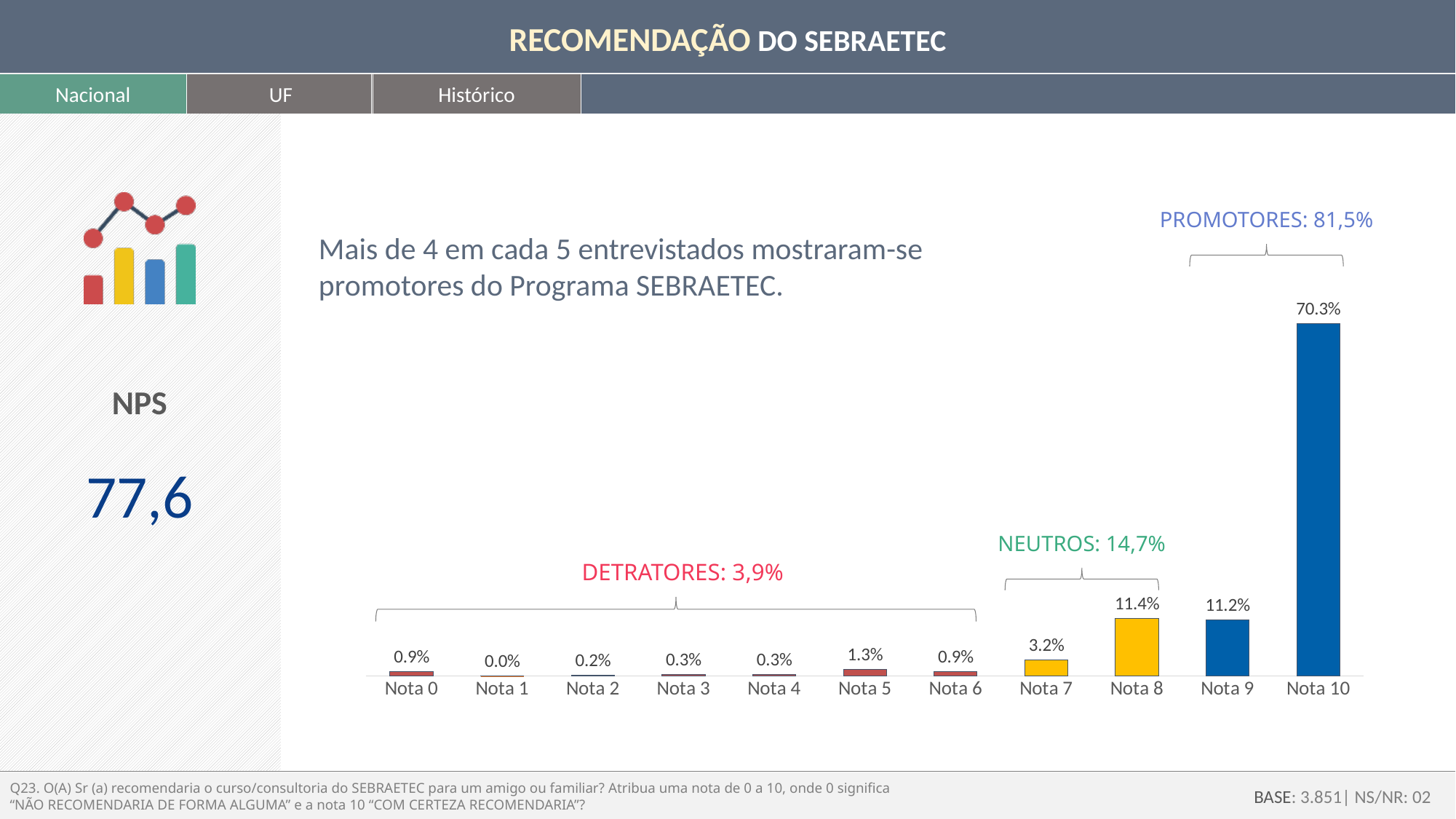
What kind of chart is shown on the slide? Bar chart Which category has the lowest value? Nota 1 What is the value for Nota 8? 11.4% What is the value for Nota 5? 1.3% What is the difference between the values for Nota 7 and Nota 6? 2.3% How many categories are shown on the x axis? 11 What percentage is labelled as PROMOTORES on the chart? 81,5% What NPS value is shown on the slide? 77,6 What is the value for Nota 10? 70.3% What is the difference between the values for Nota 10 and Nota 9? 59.1% Which category has the highest value? Nota 10 Which is larger, the value for Nota 8 or the value for Nota 9? Nota 8